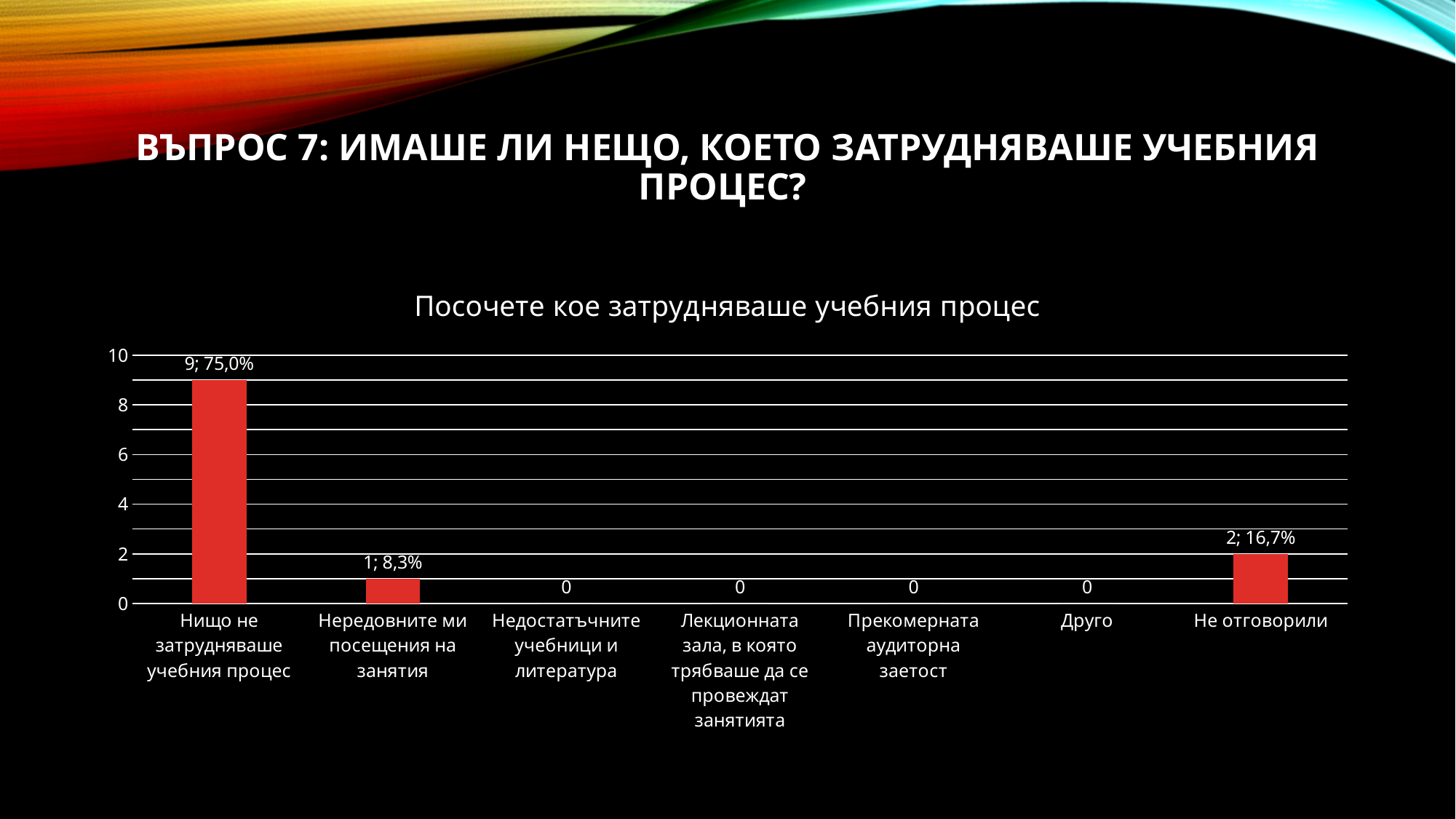
What is the value for "Нередовните ми посещения на занятия"? 1; 8,3% What kind of chart is shown on the slide? Bar chart Which is larger: the value for "Не отговорили" or the value for "Нередовните ми посещения на занятия"? Не отговорили What is the maximum value shown on the y axis? 10 What is the value for "Друго"? 0 How many categories are shown on the x axis? 7 What is the title of the chart? Посочете кое затрудняваше учебния процес What is the difference in count between "Нищо не затрудняваше учебния процес" and "Не отговорили"? 7 Which category has the highest value? Нищо не затрудняваше учебния процес What is the value for "Нищо не затрудняваше учебния процес"? 9; 75,0% How many categories have a value of 0? 4 What is the value for "Не отговорили"? 2; 16,7%